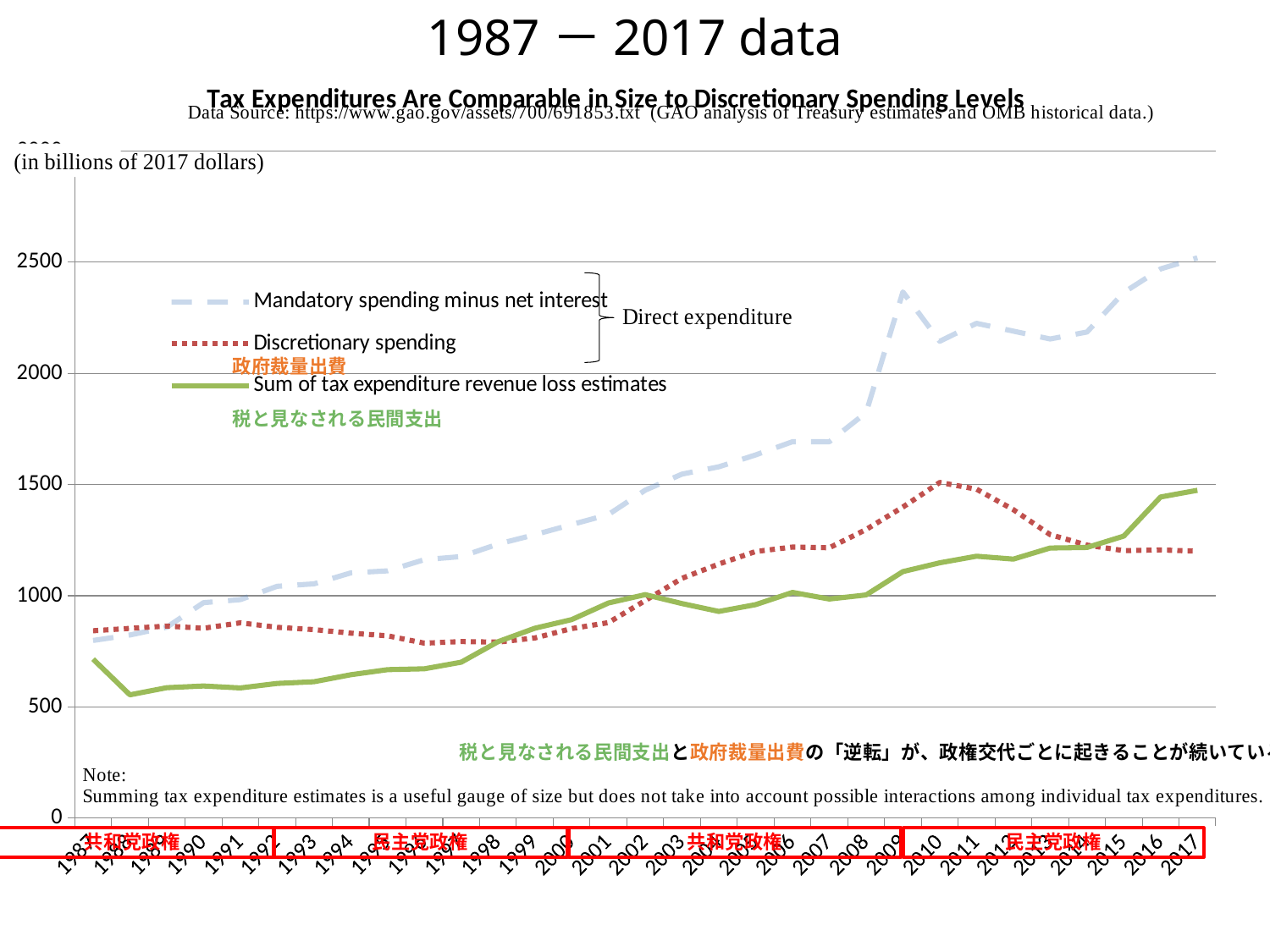
How many years are plotted along the x axis of the chart? 31 In 2017, which is larger: Discretionary spending or Sum of tax expenditure revenue loss estimates? Sum of tax expenditure revenue loss estimates Which series has the highest value in 2017? Mandatory spending minus net interest Is the value for Discretionary spending in 2010 greater or less than 1000? greater How many series does the chart's legend list? 3 Does Mandatory spending minus net interest overall rise or fall from 1987 to 2017? rise Is the value for Sum of tax expenditure revenue loss estimates in 1988 greater or less than 1000? less In 2010, which is larger: Discretionary spending or Sum of tax expenditure revenue loss estimates? Discretionary spending What kind of chart is shown on the slide? line chart Which series is drawn as the solid green line? Sum of tax expenditure revenue loss estimates Is the value for Mandatory spending minus net interest in 1987 greater or less than 1000? less